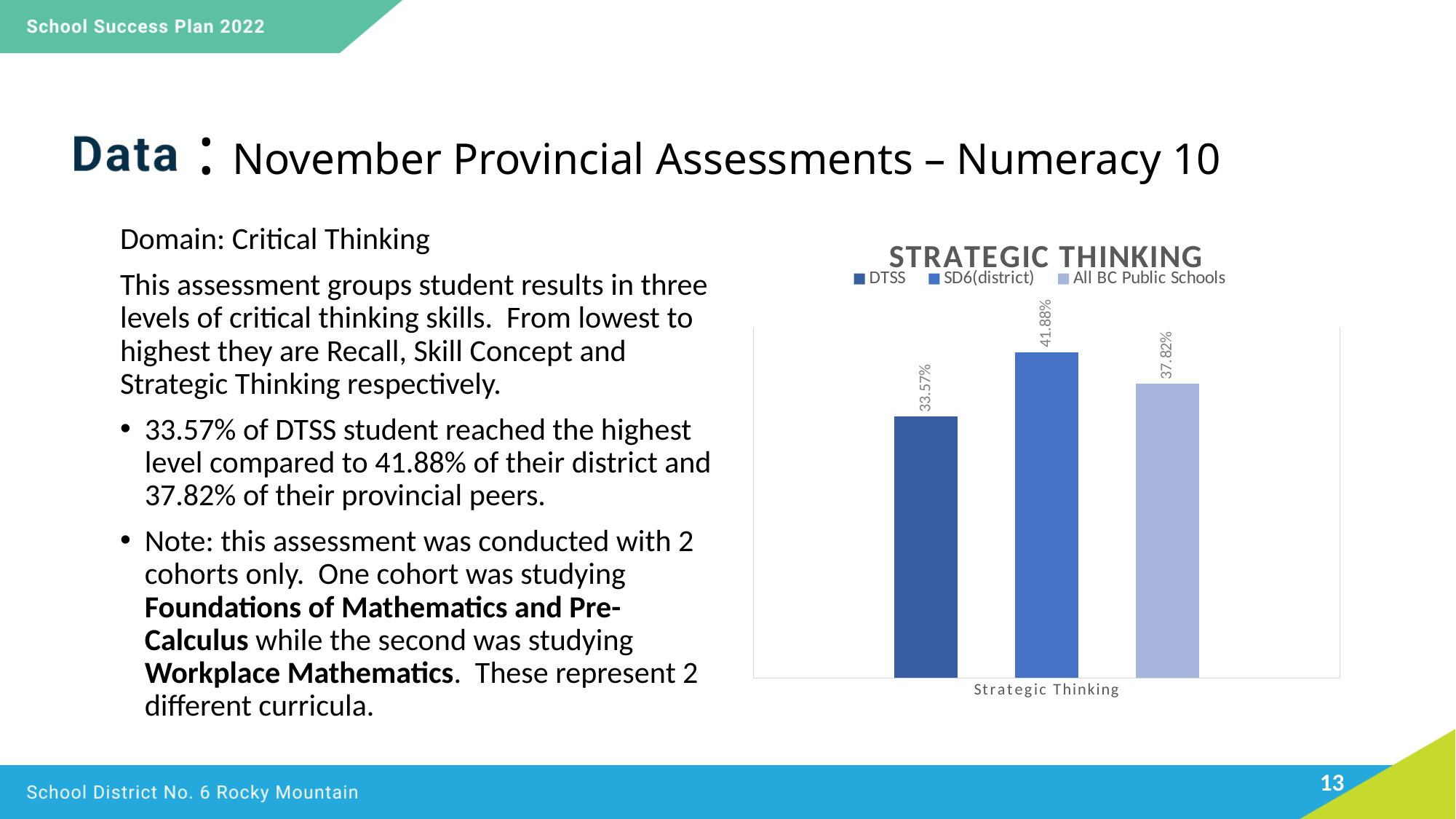
What is the value for DTSS in the Strategic Thinking chart? 33.57% What is the difference between the SD6(district) value and the DTSS value in the Strategic Thinking chart? 8.31% What is the value for All BC Public Schools in the Strategic Thinking chart? 37.82% What kind of chart is the Strategic Thinking chart? Bar chart Which series has the highest value in the Strategic Thinking chart? SD6(district) Which series has the lowest value in the Strategic Thinking chart? DTSS How many series does the legend of the Strategic Thinking chart list? 3 What is the value for SD6(district) in the Strategic Thinking chart? 41.88% What is the category label shown on the x axis of the Strategic Thinking chart? Strategic Thinking What is the difference between the SD6(district) value and the All BC Public Schools value in the Strategic Thinking chart? 4.06% What is the title of the chart on the slide? STRATEGIC THINKING Which is larger in the Strategic Thinking chart, the value for DTSS or the value for All BC Public Schools? All BC Public Schools